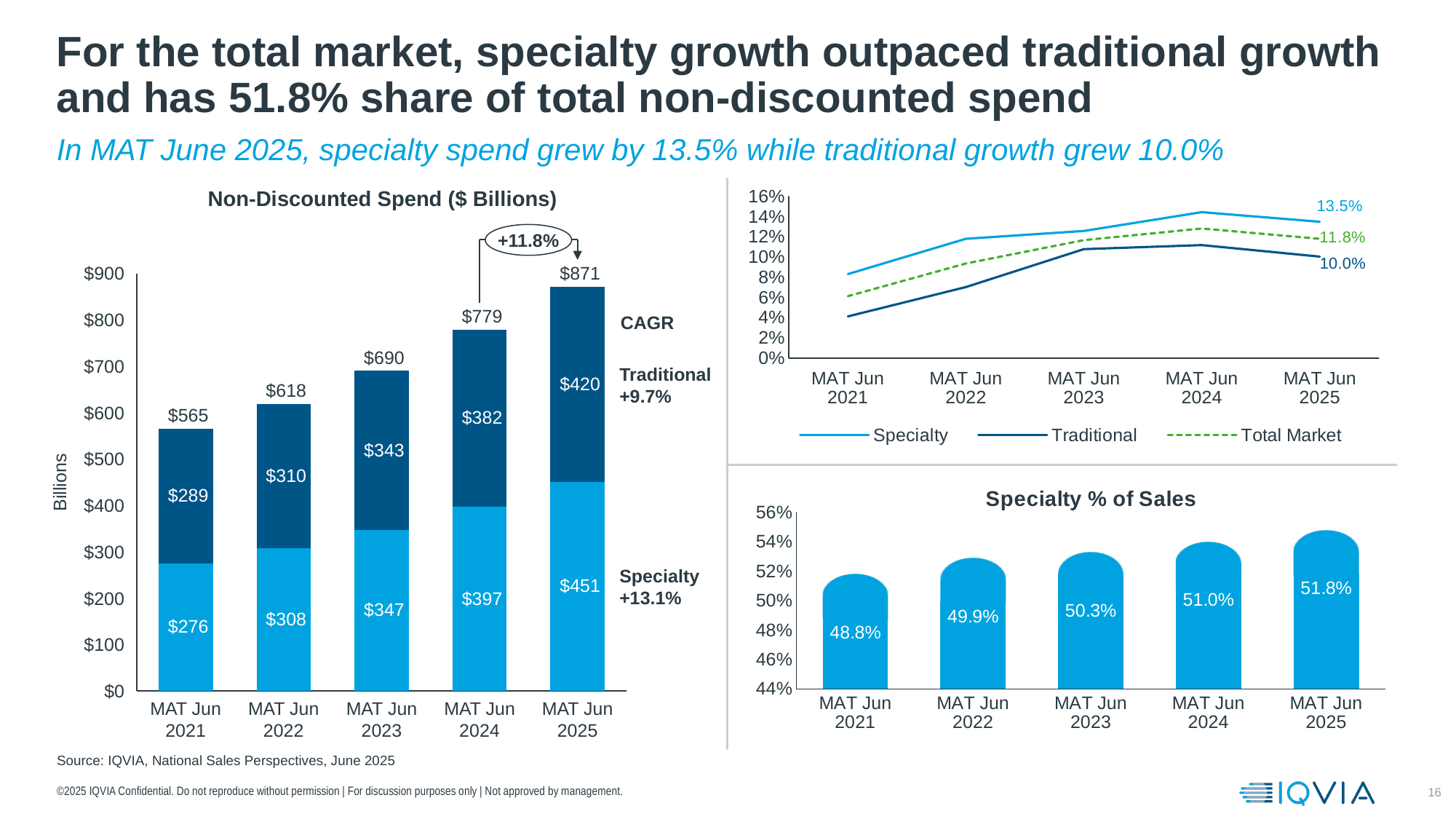
In the Specialty % of Sales chart, what is the value for MAT Jun 2022? 49.9% In the Non-Discounted Spend ($ Billions) chart, what is the difference between the Specialty and Traditional values for MAT Jun 2021? $13 In the Non-Discounted Spend ($ Billions) chart, which period has the highest total spend? MAT Jun 2025 In the Non-Discounted Spend ($ Billions) chart, what kind of chart is shown? Stacked bar chart In the Specialty % of Sales chart, do the values rise or fall from MAT Jun 2021 to MAT Jun 2025? Rise In the Non-Discounted Spend ($ Billions) chart, what is the CAGR shown for Specialty? +13.1% In the top-right line chart, what is the Specialty growth value for MAT Jun 2025? 13.5% In the top-right line chart, is the Traditional value for MAT Jun 2021 greater or less than 6%? less In the Non-Discounted Spend ($ Billions) chart, what is the total of the stacked bar for MAT Jun 2024? $779 In the top-right line chart, how many series does the legend list? 3 In the Non-Discounted Spend ($ Billions) chart, what is the Specialty value for MAT Jun 2023? $347 In the Non-Discounted Spend ($ Billions) chart, what is the Traditional value for MAT Jun 2025? $420